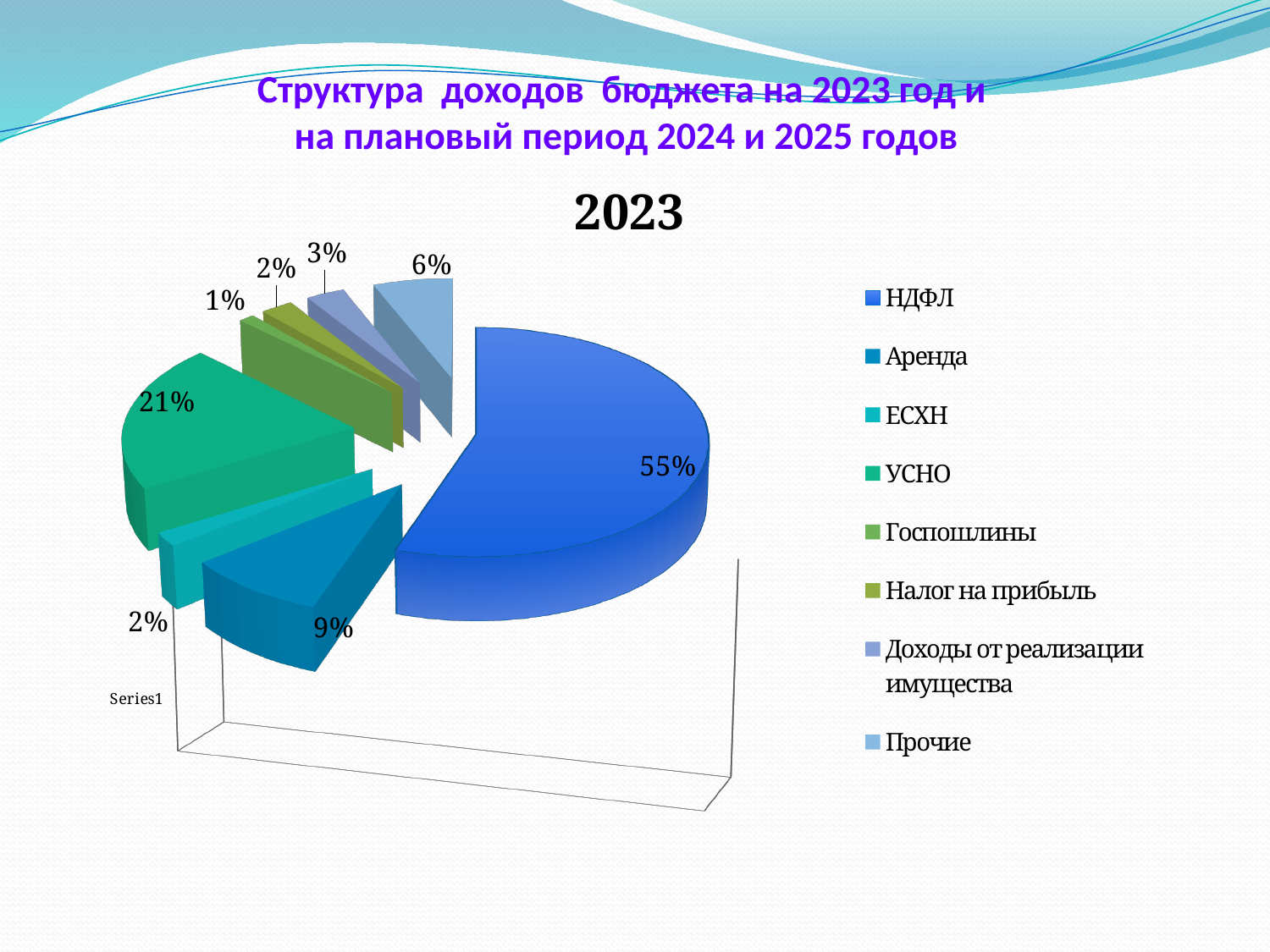
Which category has the largest share of the pie? НДФЛ What is the value for Аренда? 9% What is the value for УСНО? 21% What is the value for Прочие? 6% Which is larger, the share of Аренда or the share of Прочие? Аренда What is the difference between the shares of НДФЛ and УСНО? 34% Which category has the smallest share of the pie? Госпошлины What share of the pie does НДФЛ have? 55% What is the title of the chart? 2023 What is the value for Доходы от реализации имущества? 3% What kind of chart is shown on the slide? pie chart How many categories does the legend list? 8